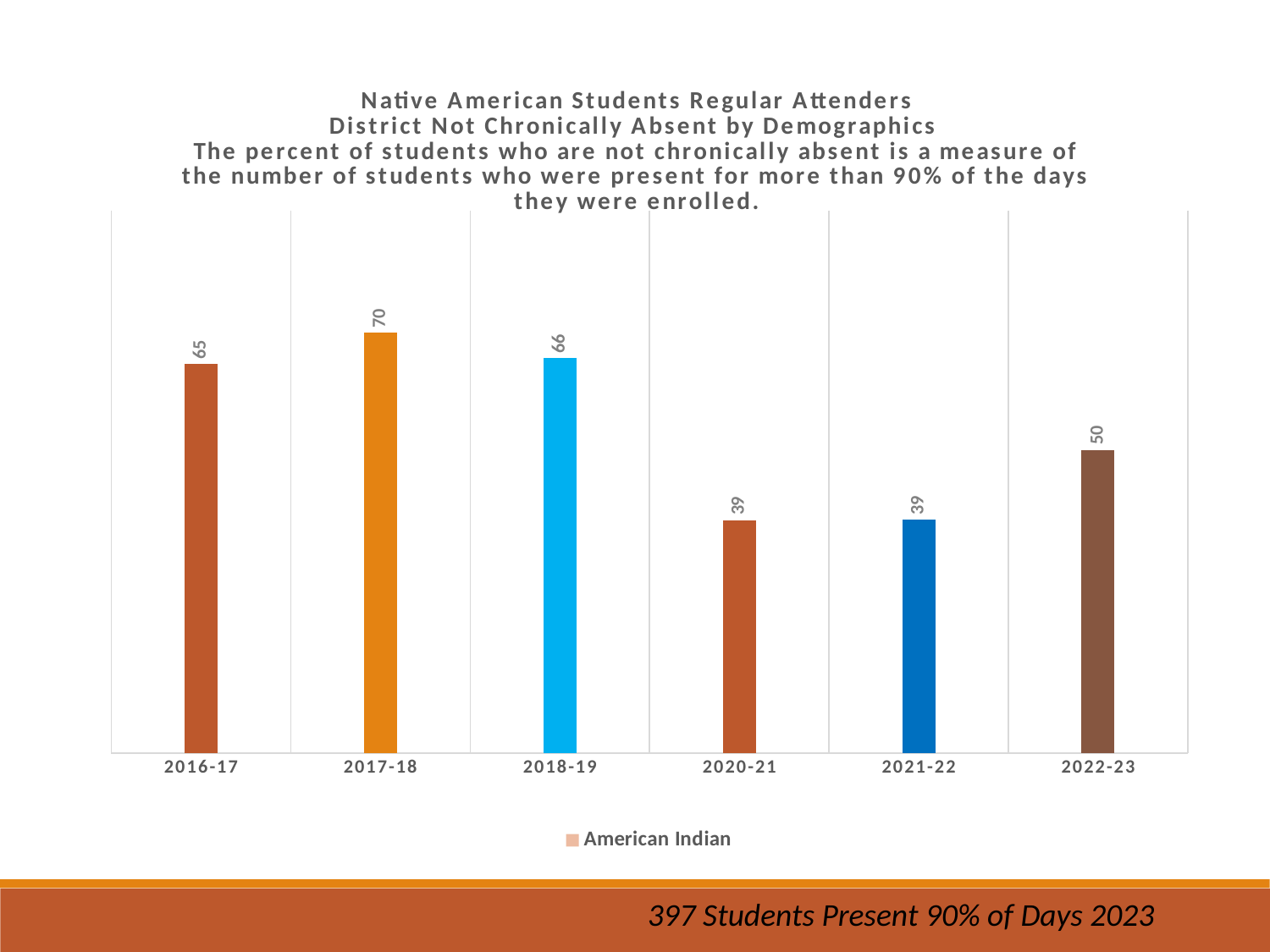
What is the value for 2017-18? 70 What is the value for 2016-17? 65 What is the lowest value shown on the chart? 39 How many years are shown on the x axis? 6 What is the value for 2022-23? 50 What is the legend entry shown below the chart? American Indian What kind of chart is shown on the slide? bar chart Which year has the highest value? 2017-18 What is the difference between the values for 2018-19 and 2020-21? 27 What is the difference between the values for 2017-18 and 2022-23? 20 Which is larger, the value for 2016-17 or the value for 2018-19? 2018-19 How many series does the legend list? 1